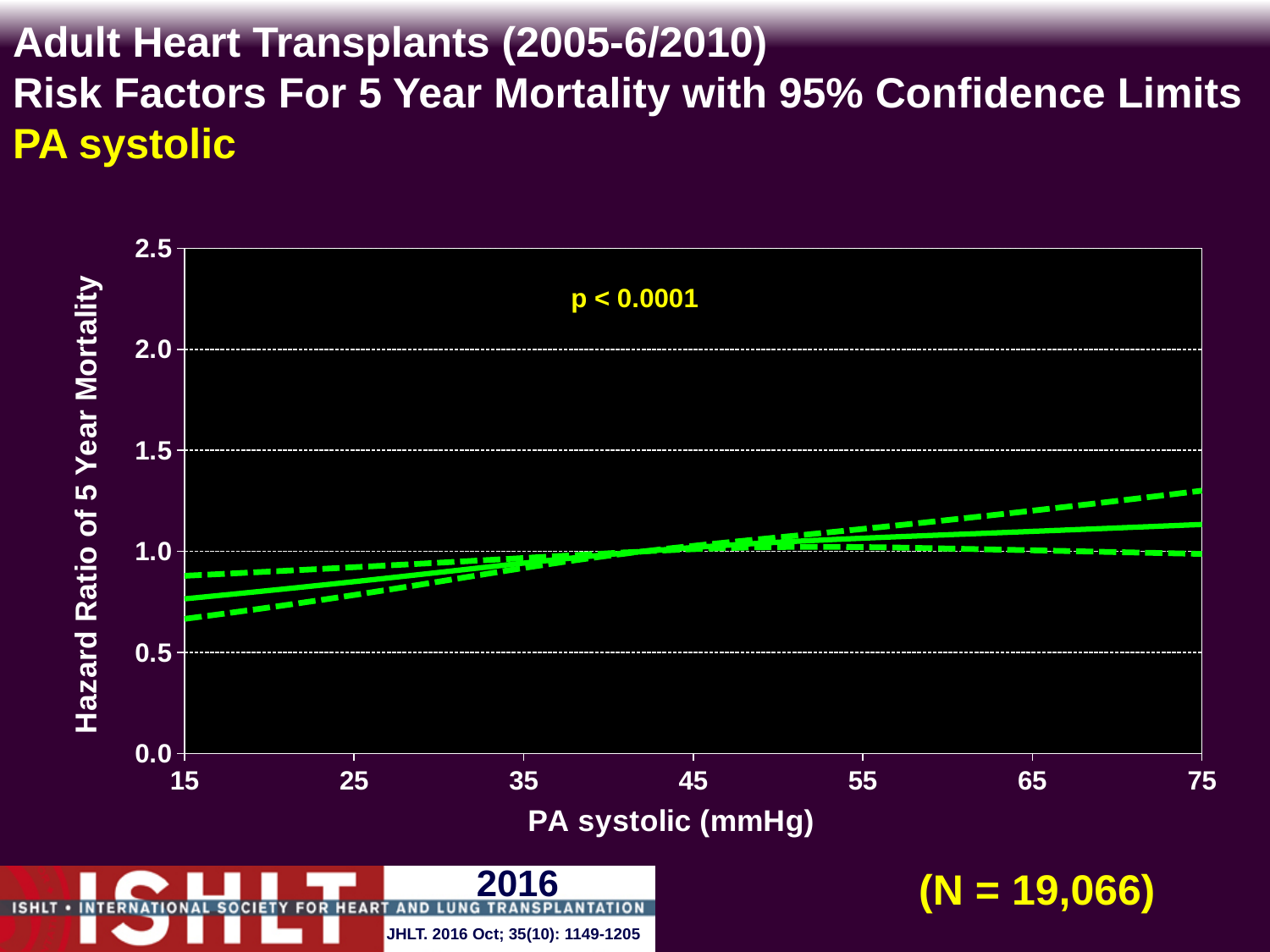
What sample size (N) is shown on the slide? N = 19,066 Is the upper 95% confidence limit at a PA systolic of 75 mmHg greater or less than 1.0? greater Which is larger, the hazard ratio at a PA systolic of 15 mmHg or at 75 mmHg? 75 mmHg What p-value is printed on the chart? p < 0.0001 Is the hazard ratio (solid line) at a PA systolic of 75 mmHg greater or less than 1.5? less Is the hazard ratio (solid line) at a PA systolic of 15 mmHg greater or less than 1.0? less How many lines are plotted on the chart? 3 What kind of chart is shown on the slide? line chart Does the hazard ratio of 5 year mortality rise or fall as PA systolic increases from 15 to 75 mmHg? rise